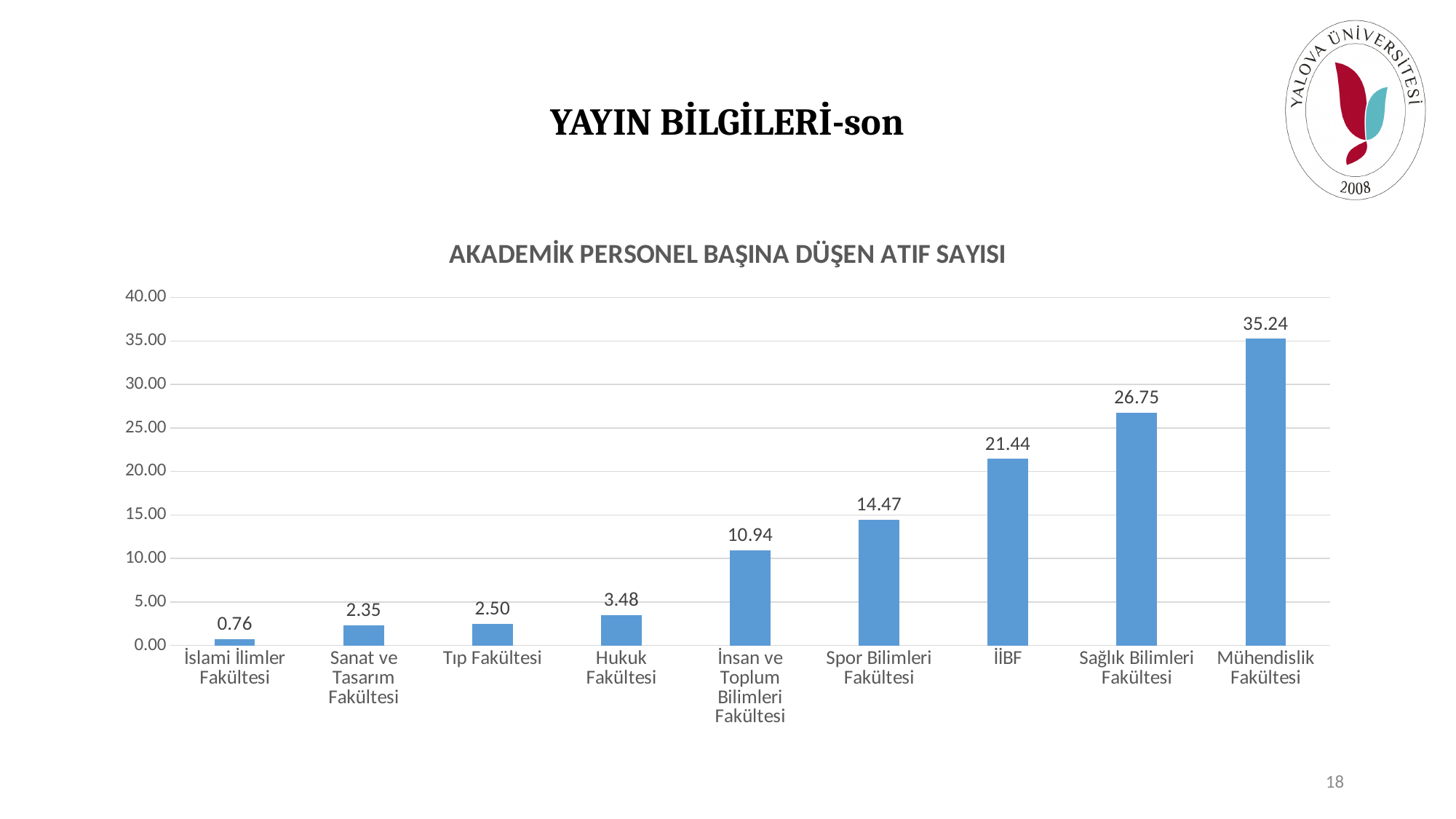
What is the title of the chart? AKADEMİK PERSONEL BAŞINA DÜŞEN ATIF SAYISI Do the values rise or fall from left to right along the x axis? rise How many categories are shown on the x axis? 9 Which category has the highest value? Mühendislik Fakültesi What is the difference between the values for Sağlık Bilimleri Fakültesi and Spor Bilimleri Fakültesi? 12.28 Is the value for İnsan ve Toplum Bilimleri Fakültesi greater or less than 10.00? greater Which category has the lowest value? İslami İlimler Fakültesi Which is larger, the value for Tıp Fakültesi or the value for Sanat ve Tasarım Fakültesi? Tıp Fakültesi What is the value for İİBF? 21.44 What kind of chart is shown on the slide? bar chart What is the value for Hukuk Fakültesi? 3.48 What is the value for Mühendislik Fakültesi? 35.24